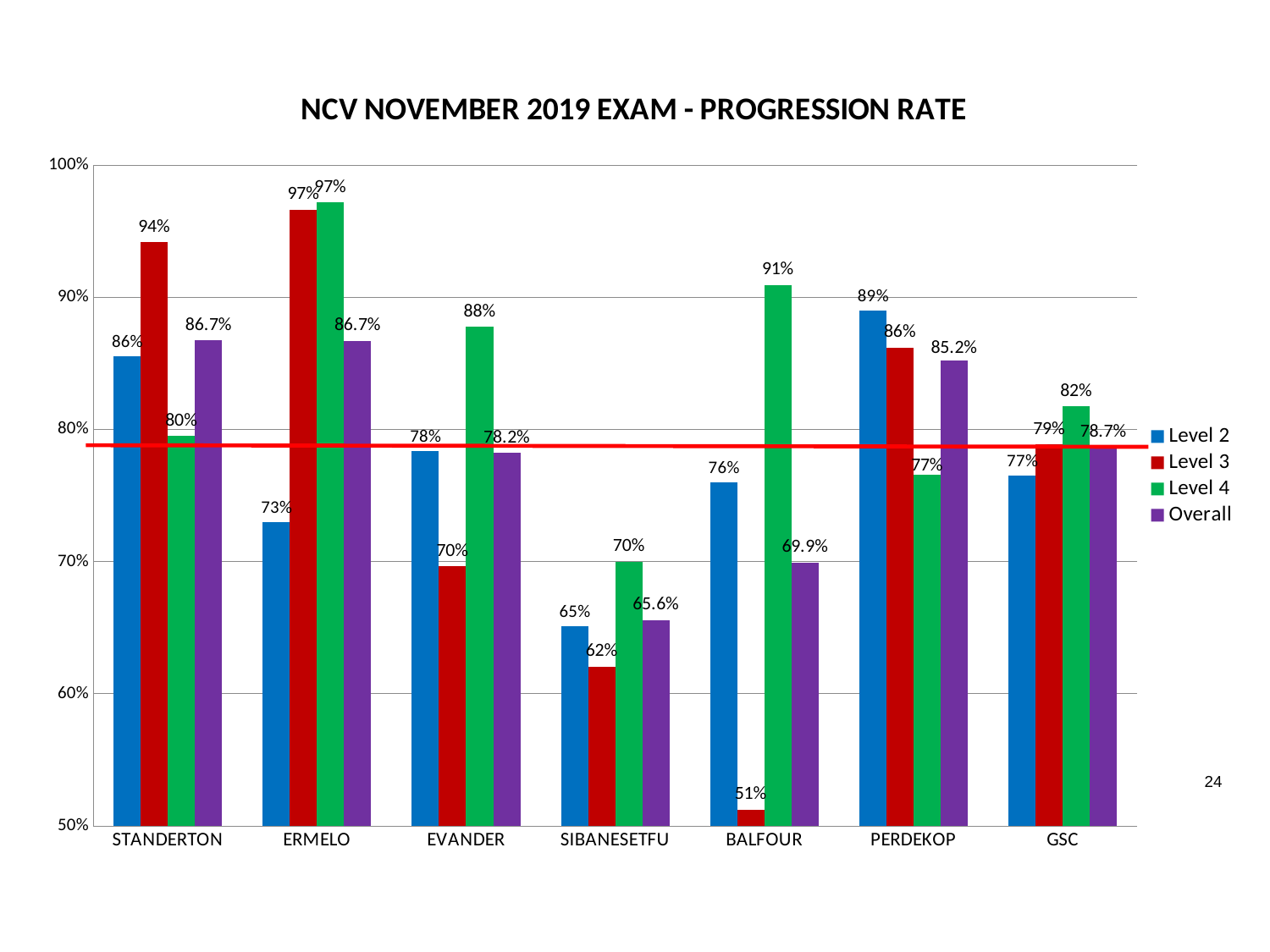
What kind of chart is shown on the slide? Bar chart Which campus has the lowest Level 3 progression rate? BALFOUR What is the title of the chart? NCV NOVEMBER 2019 EXAM - PROGRESSION RATE What is the difference between the Level 4 and Level 3 progression rates for BALFOUR? 40% Which is higher for EVANDER, the Level 2 rate or the Level 4 rate? Level 4 What is the Level 3 progression rate for STANDERTON? 94% How many series does the legend list? 4 How many campuses are shown on the x axis? 7 What is the Level 4 progression rate for BALFOUR? 91% What is the Overall progression rate for PERDEKOP? 85.2% Which campus has the lowest Overall progression rate? SIBANESETFU Which campus has the highest Level 2 progression rate? PERDEKOP